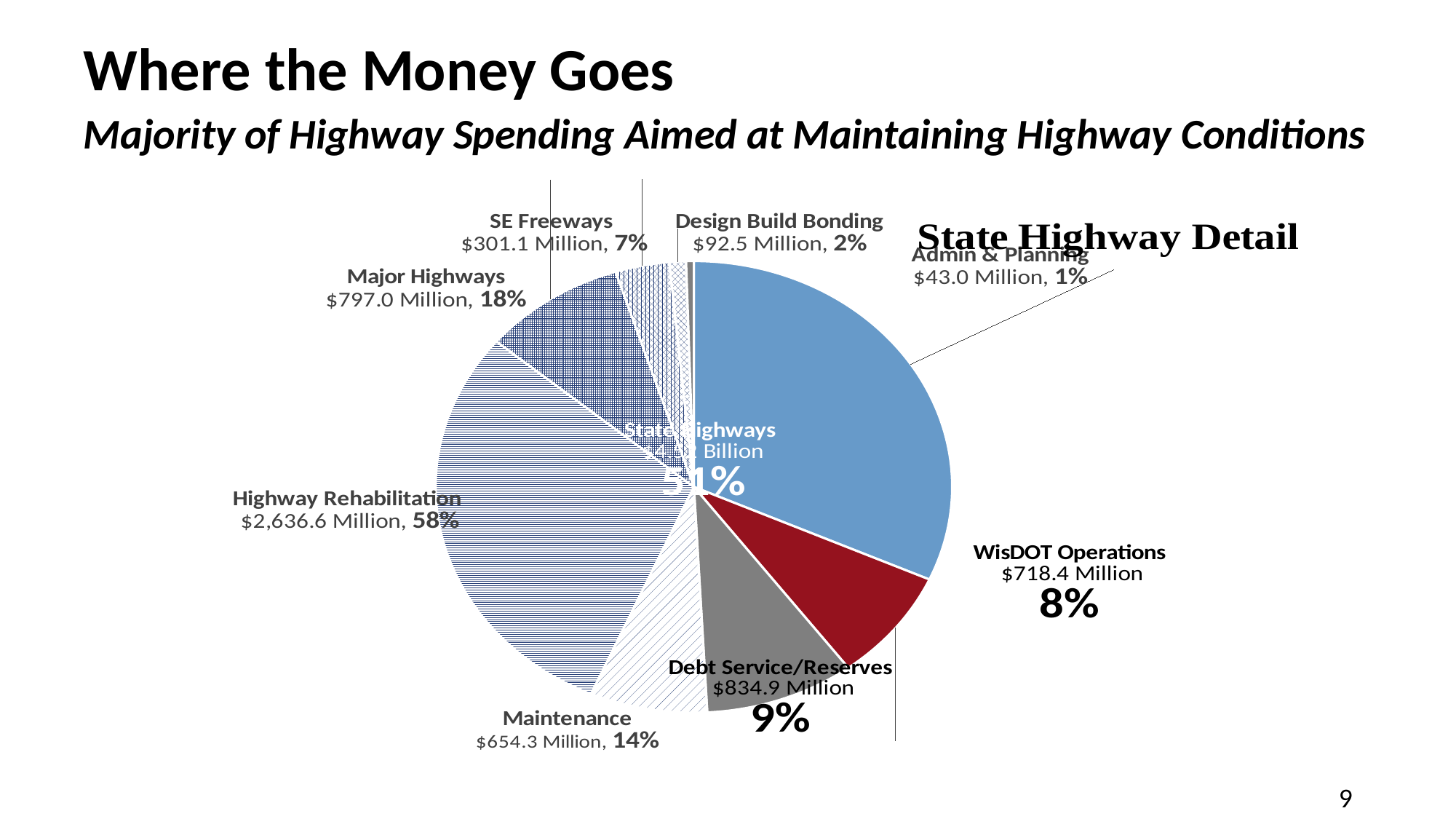
What is the dollar amount shown for Admin & Planning? $43.0 Million What is the dollar amount shown for Highway Rehabilitation? $2,636.6 Million What is the dollar amount shown for WisDOT Operations? $718.4 Million Which is larger, Debt Service/Reserves or WisDOT Operations? Debt Service/Reserves What is the dollar amount shown for Major Highways? $797.0 Million What is the dollar amount shown for Design Build Bonding? $92.5 Million What kind of chart is shown on the slide? pie chart What percentage is shown for Maintenance? 14% What percentage is shown for Debt Service/Reserves? 9% What percentage is shown for SE Freeways? 7% Among the State Highway Detail categories, which has the largest dollar amount? Highway Rehabilitation What is the difference in dollars between Debt Service/Reserves and WisDOT Operations? $116.5 Million